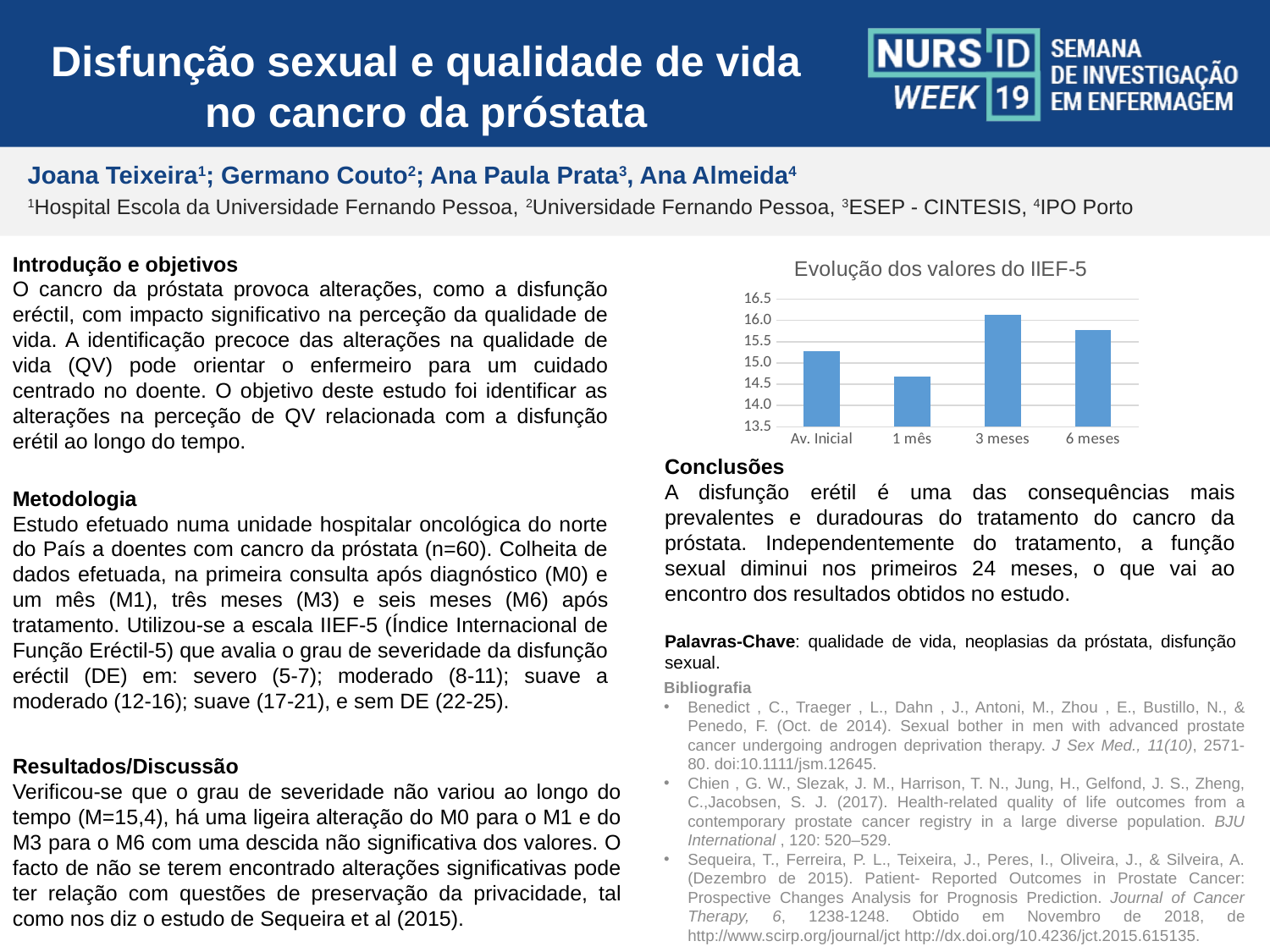
Is the value for Av. Inicial greater or less than 15.0? greater What type of chart is shown on the slide? bar chart Which category has the highest value in the chart? 3 meses How many categories are shown on the x axis of the chart? 4 Is the value for 1 mês greater or less than 15.0? less Does the value rise or fall from Av. Inicial to 1 mês? fall Which is larger, the value for Av. Inicial or the value for 6 meses? 6 meses Is the value for 3 meses greater or less than 15.5? greater What is the title of the chart? Evolução dos valores do IIEF-5 Which category has the lowest value in the chart? 1 mês Which is larger, the value for 3 meses or the value for 1 mês? 3 meses